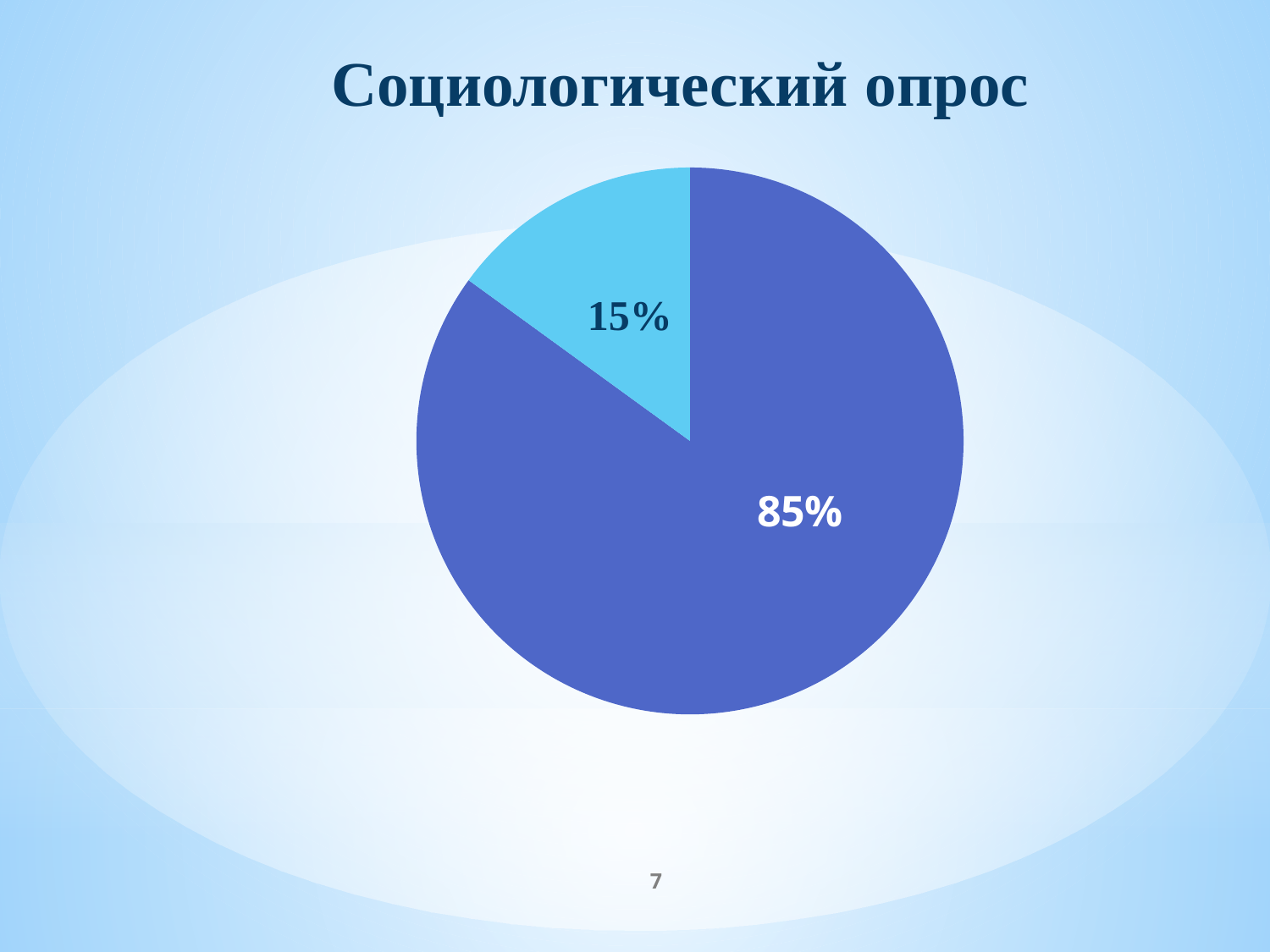
Which slice is the largest in the pie chart? the dark blue slice (85%) What is the title of the slide containing the pie chart? Социологический опрос What share of the pie does the dark blue slice represent? 85% What kind of chart is shown on the slide? pie chart Is the share of the light blue slice greater or less than 50%? less What is the difference in percentage points between the two slices of the pie chart? 70 What is the total of the two percentages shown on the pie chart? 100% What colour is the slice labelled 85%? dark blue What share of the pie does the light blue slice represent? 15% Which is larger, the dark blue slice or the light blue slice? the dark blue slice How many slices does the pie chart have? 2 Which slice is the smallest in the pie chart? the light blue slice (15%)